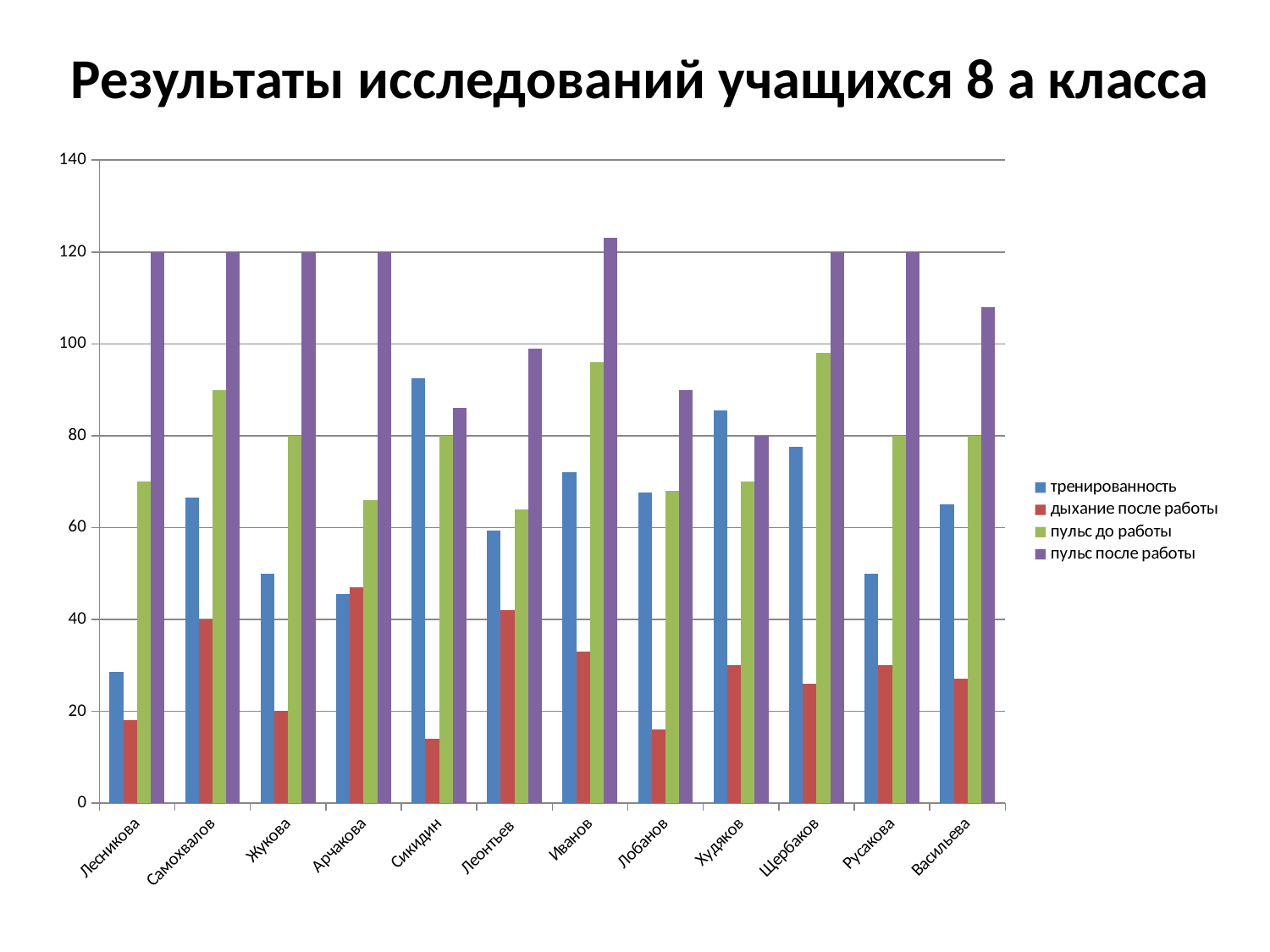
What is the value of 'дыхание после работы' for Самохвалов? 40 What kind of chart is shown on the slide? bar chart What is the value of 'пульс до работы' for Жукова? 80 How many series does the legend list? 4 Which student has the highest value for 'тренированность'? Сикидин Is the value of 'пульс после работы' for Иванов greater or less than 120? greater Which student has the lowest value for 'тренированность'? Лесникова What is the title of the chart on the slide? Результаты исследований учащихся 8 а класса Which is larger: 'тренированность' for Сикидин or for Худяков? Сикидин How many students (categories) are shown on the x axis? 12 Which student has the highest value for 'пульс после работы'? Иванов What is the value of 'пульс после работы' for Лесникова? 120